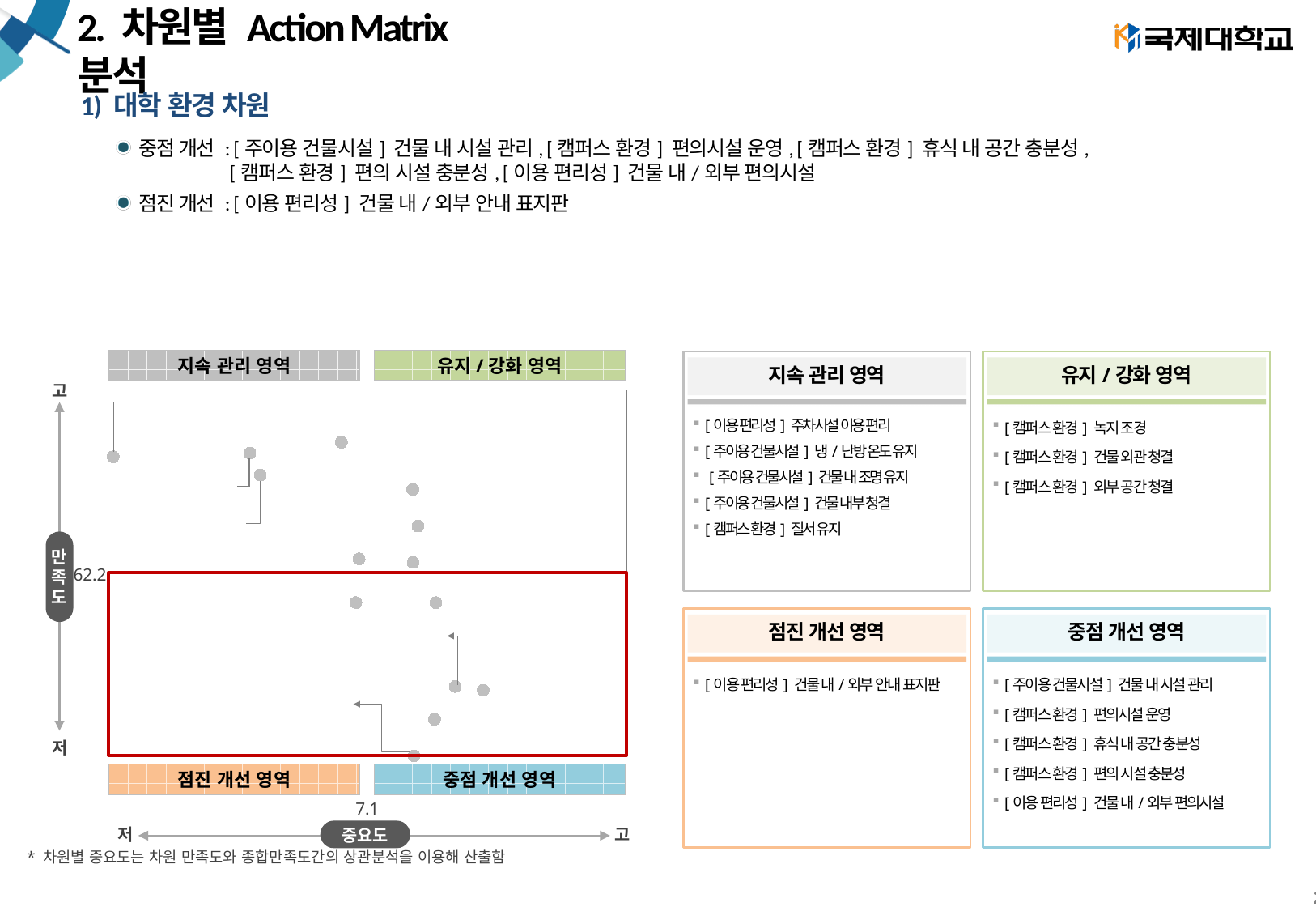
How many data points are plotted in the 유지 / 강화 영역 (top-right area)? 3 What kind of chart is shown on the slide? scatter chart What is the label of the vertical axis of the action matrix? 만족도 What value is marked on the vertical (만족도) axis as the boundary between the upper and lower areas of the matrix? 62.2 What is the name of the top-right area of the action matrix? 유지 / 강화 영역 How many data points are plotted in total on the action matrix? 14 How many data points are plotted in the 점진 개선 영역 (bottom-left area)? 1 What value is marked on the horizontal (중요도) axis as the boundary between the left and right areas of the matrix? 7.1